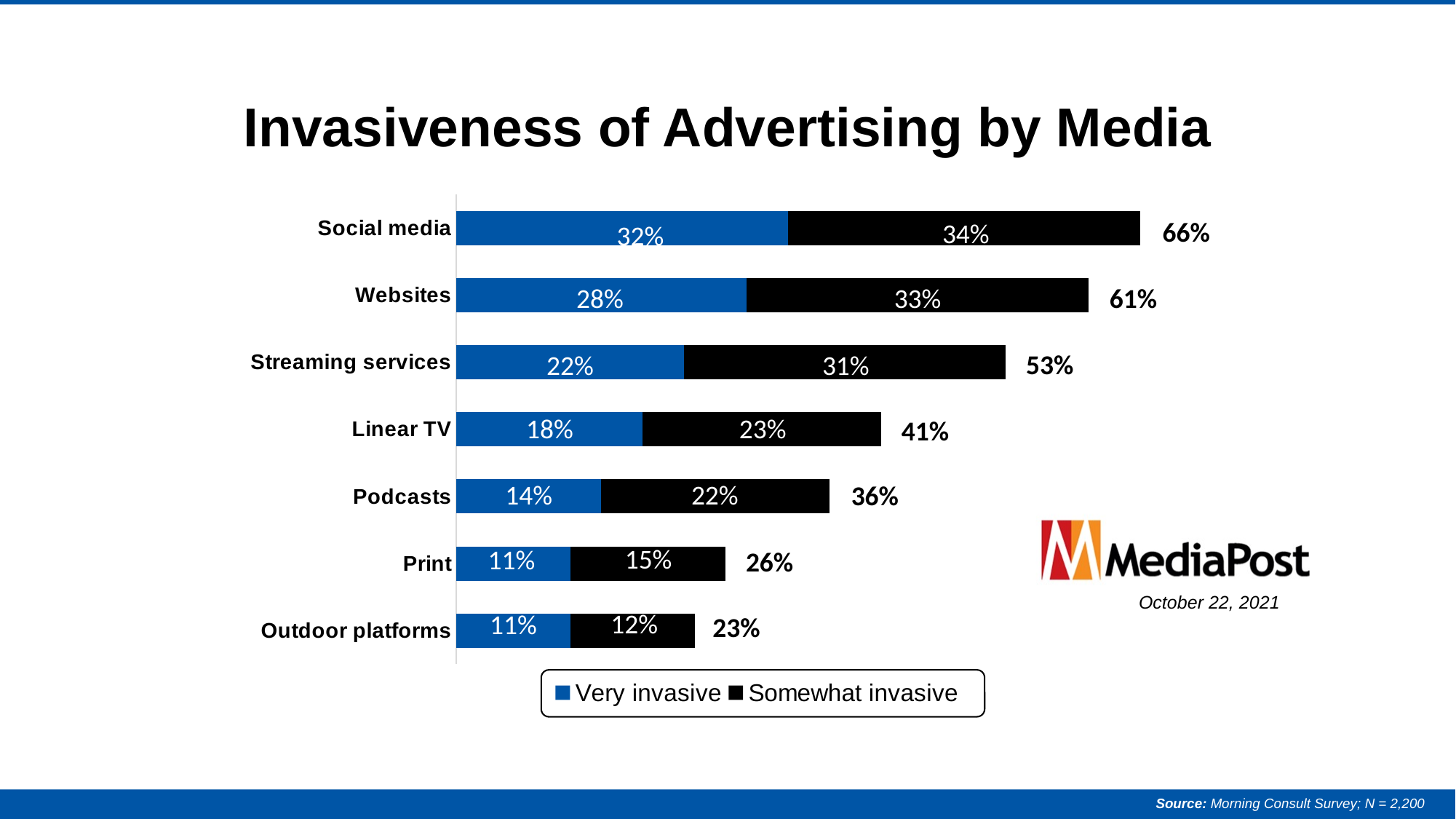
What percentage of respondents find social media advertising very invasive? 32% Which colour represents 'Very invasive' in the chart? Blue How many media categories are shown in the chart? 7 How many series does the legend list? 2 What is the 'Somewhat invasive' value for Streaming services? 31% Which media category has the highest total invasiveness? Social media What is the total for Linear TV? 41% What kind of chart is shown on the slide? Stacked bar chart What is the title of the chart? Invasiveness of Advertising by Media Which has a larger 'Somewhat invasive' value, Print or Podcasts? Podcasts Which media category has the lowest total invasiveness? Outdoor platforms What is the difference between the 'Very invasive' values for Websites and Podcasts? 14%